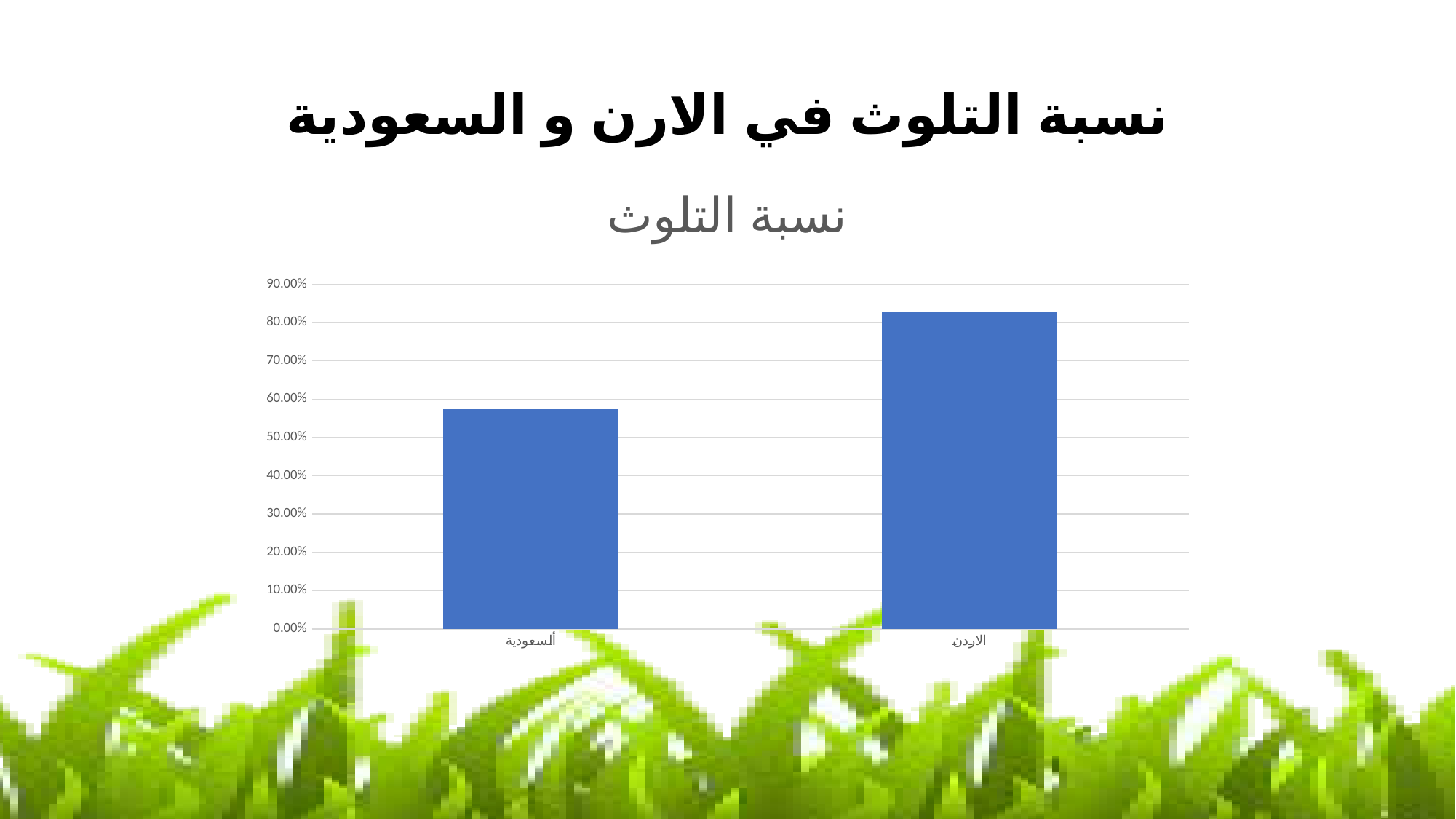
What is the title of the chart? نسبة التلوث Is the value for السعودية greater or less than 60.00%? less What kind of chart is shown on the slide? bar chart Is the value for الاردن greater or less than 80.00%? greater What is the highest value shown on the vertical axis of the chart? 90.00% Which is larger, the value for السعودية or the value for الاردن? الاردن How many categories are plotted in the chart? 2 Is the value for الاردن greater or less than 90.00%? less Which category has the highest value in the chart? الاردن Which category has the lowest value in the chart? ألسعودية